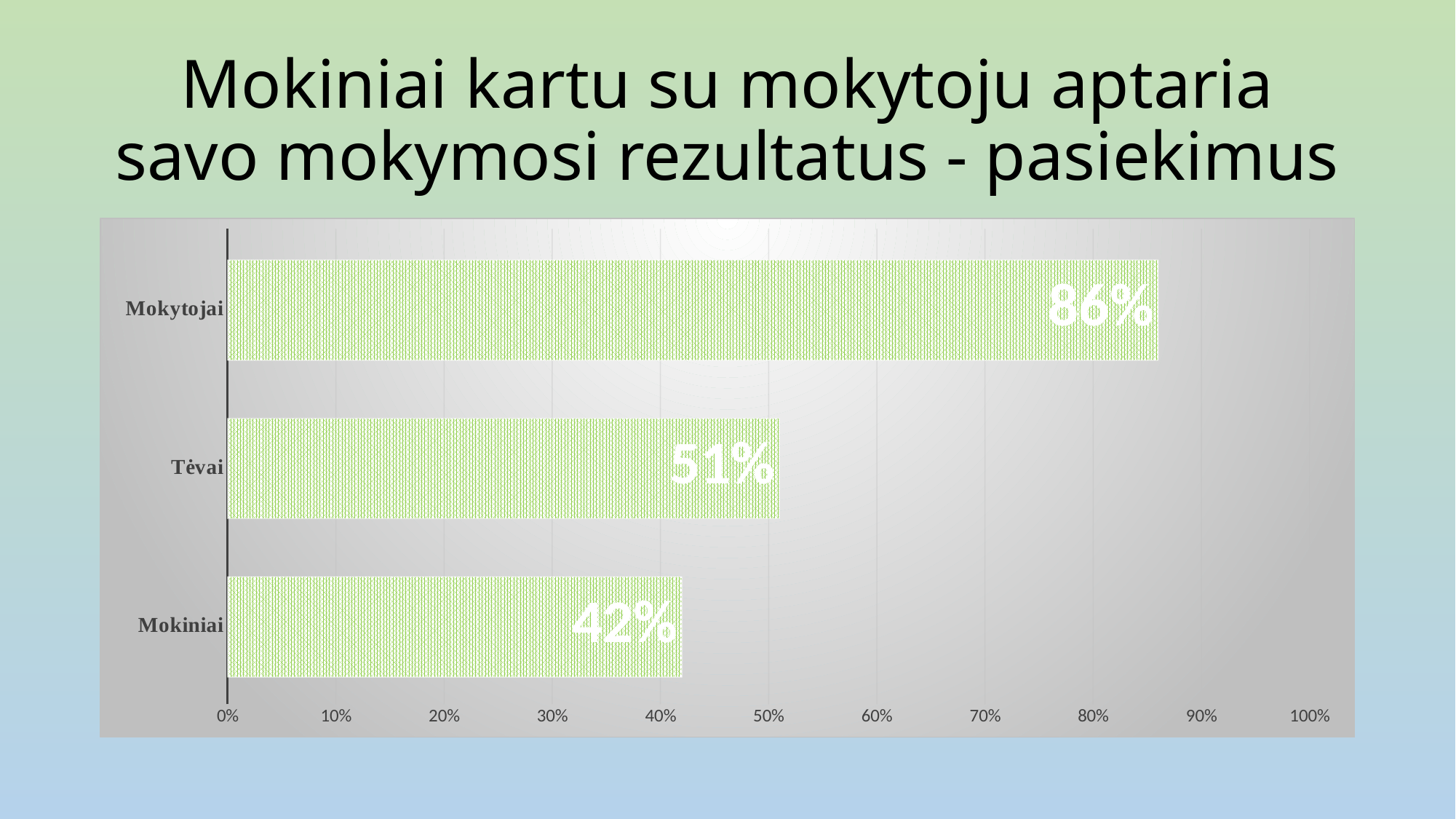
What is the value for Mokiniai? 42% What is the value for Tėvai? 51% Which category has the lowest value? Mokiniai What is the difference between the values for Tėvai and Mokiniai? 9% What is the title of the slide containing the chart? Mokiniai kartu su mokytoju aptaria savo mokymosi rezultatus - pasiekimus What is the difference between the values for Mokytojai and Mokiniai? 44% How many categories are shown in the chart? 3 Which is larger, the value for Tėvai or the value for Mokiniai? Tėvai What is the value for Mokytojai? 86% Which category has the highest value? Mokytojai What kind of chart is shown on the slide? bar chart Is the value for Mokytojai greater or less than 80%? greater